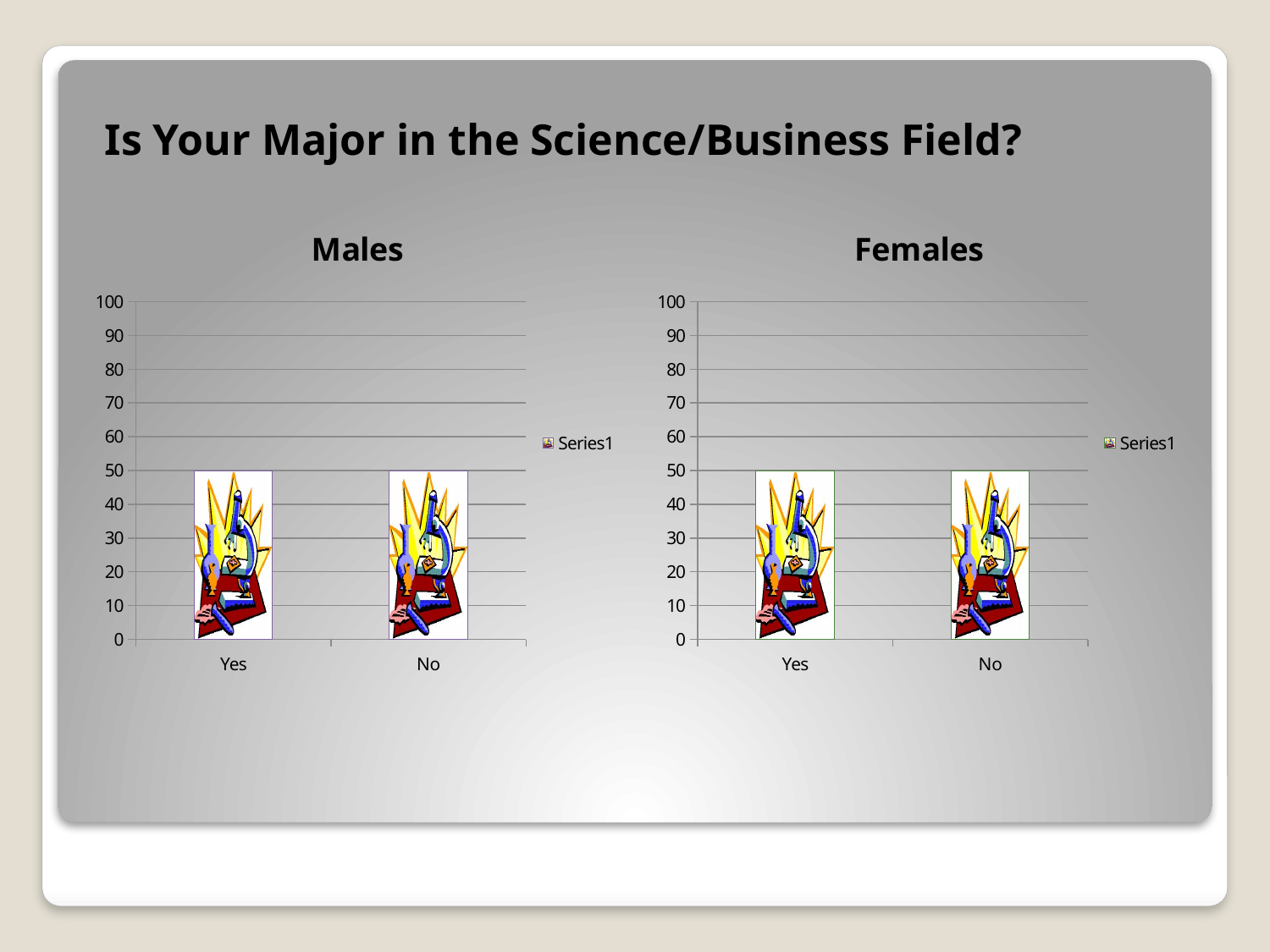
In the Males chart, what is the difference between the values for Yes and No? 0 How many series does the legend of the Males chart list? 1 How many categories are shown on the x axis of the Females chart? 2 What kind of chart is the Females chart? bar chart In the Females chart, is the value for No greater or less than 60? less What is the legend entry shown in the Females chart? Series1 In the Males chart, what is the value for No? 50 In the Males chart, is the value for Yes greater or less than 40? greater In the Females chart, what is the value for No? 50 What is the title of the chart on the left side of the slide? Males In the Females chart, what is the value for Yes? 50 In the Males chart, what is the value for Yes? 50